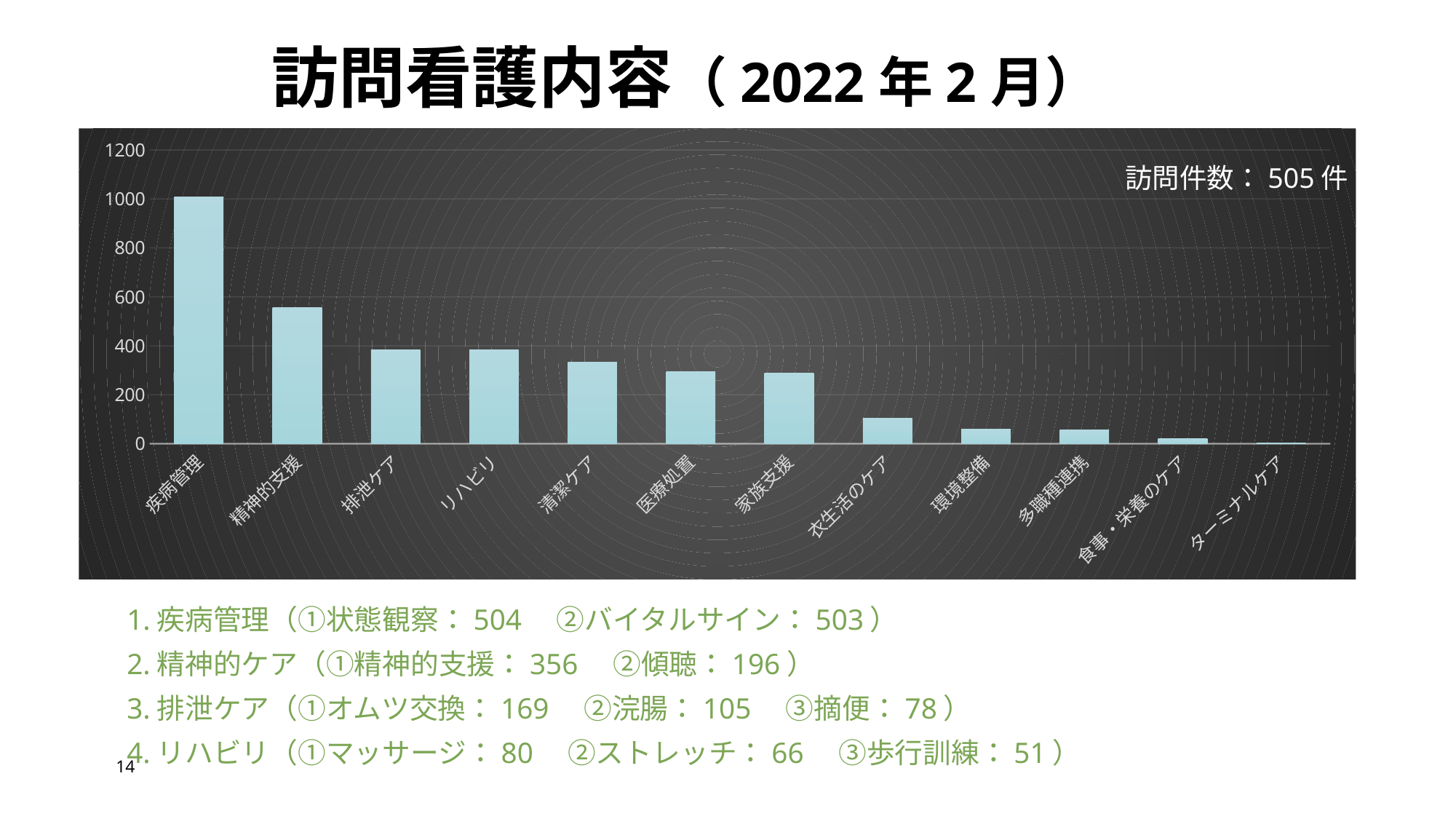
Which is larger, the value for 疾病管理 or the value for 精神的支援? 疾病管理 Is the value for 精神的支援 greater or less than 600? less Which category has the lowest value? ターミナルケア What kind of chart is shown on the slide? bar chart How many categories are plotted on the chart? 12 Which category has the highest value? 疾病管理 Which is larger, the value for 清潔ケア or the value for 衣生活のケア? 清潔ケア Is the value for 疾病管理 greater or less than 800? greater Do the values rise or fall from left to right along the x axis? fall Is the value for 環境整備 greater or less than 200? less What total number of visits (訪問件数) is noted on the chart? 505件